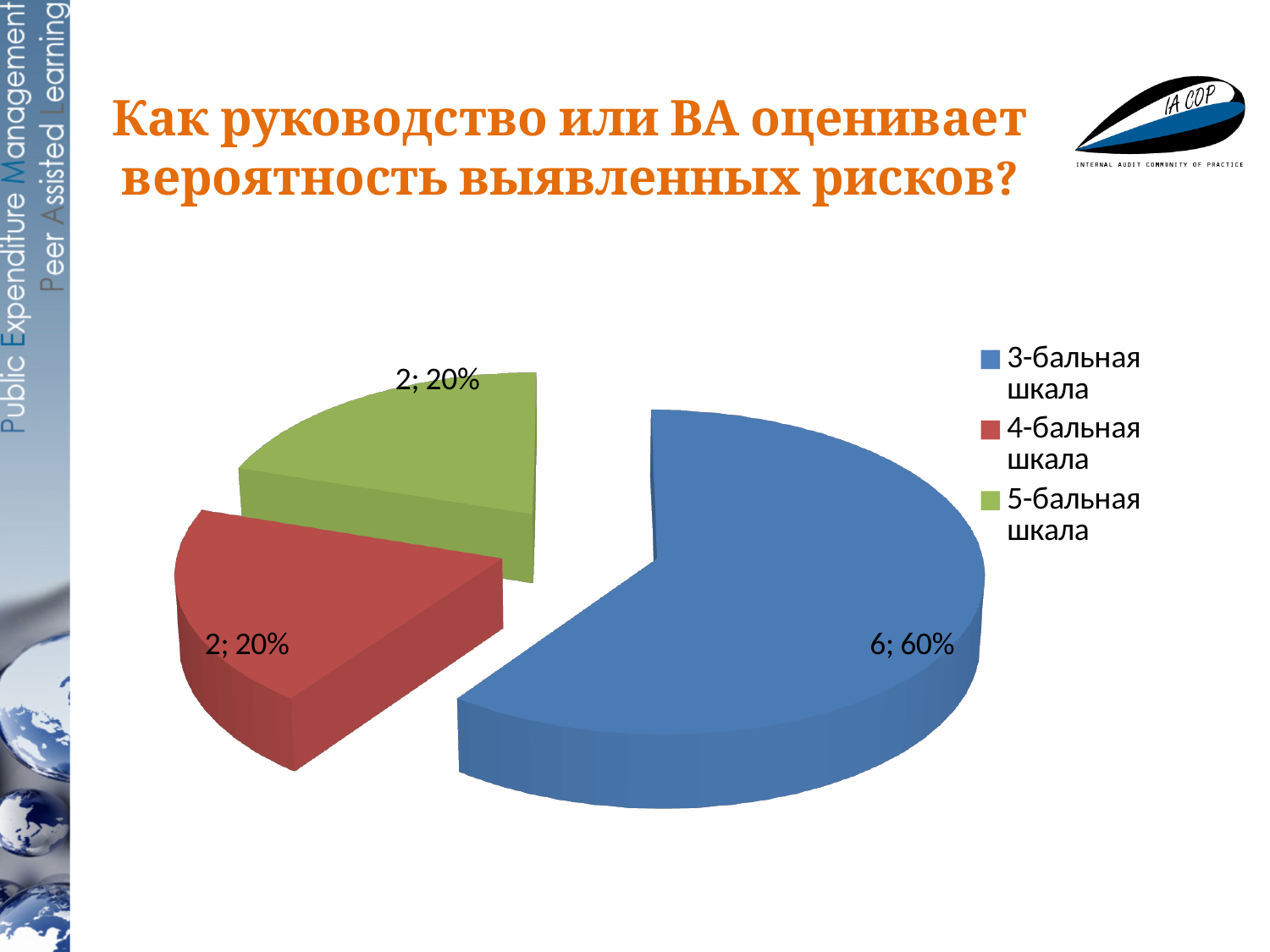
How many entries does the legend list? 3 How many slices does the pie chart have? 3 What share of the pie does the 5-бальная шкала slice represent? 20% What share of the pie does the 3-бальная шкала slice represent? 60% What is the count shown for the 3-бальная шкала slice? 6 What colour is the 4-бальная шкала slice? red What kind of chart is shown on the slide? pie chart Which is larger: the 3-бальная шкала slice or the 5-бальная шкала slice? 3-бальная шкала What is the total count across all slices of the pie? 10 What is the difference in count between the 3-бальная шкала slice and the 4-бальная шкала slice? 4 What is the count shown for the 4-бальная шкала slice? 2 Which category has the largest slice of the pie? 3-бальная шкала